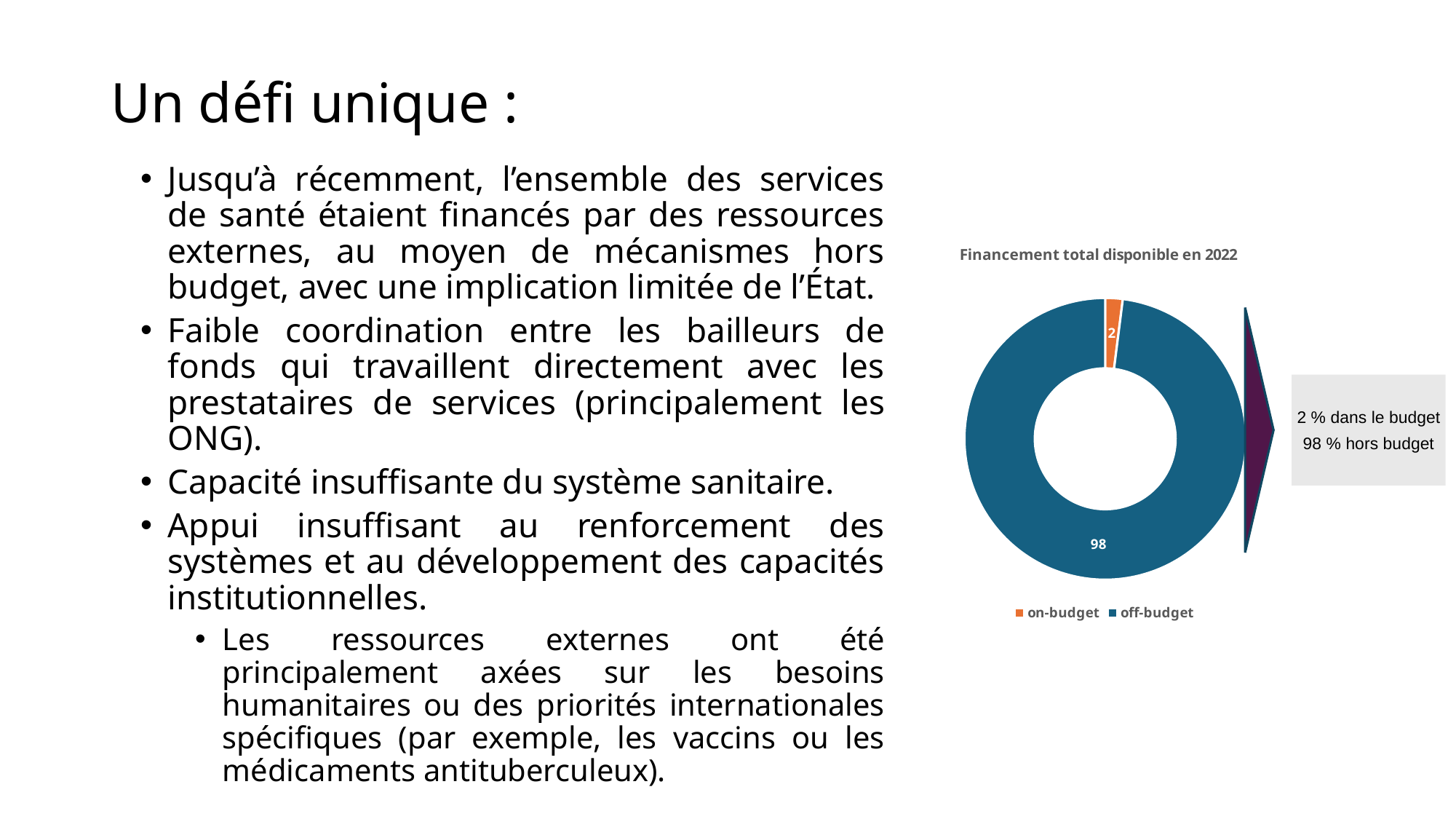
What is the value for on-budget? 2 How many entries does the legend list? 2 Which category has the largest share? off-budget What kind of chart is shown on the slide? Doughnut chart What colour is the on-budget slice? Orange What share of the total does the off-budget slice represent? 98% What is the value for off-budget? 98 What is the title of the chart? Financement total disponible en 2022 How many categories does the chart show? 2 What is the difference between the off-budget and on-budget values? 96 Which is larger, on-budget or off-budget? off-budget Which category has the smallest share? on-budget